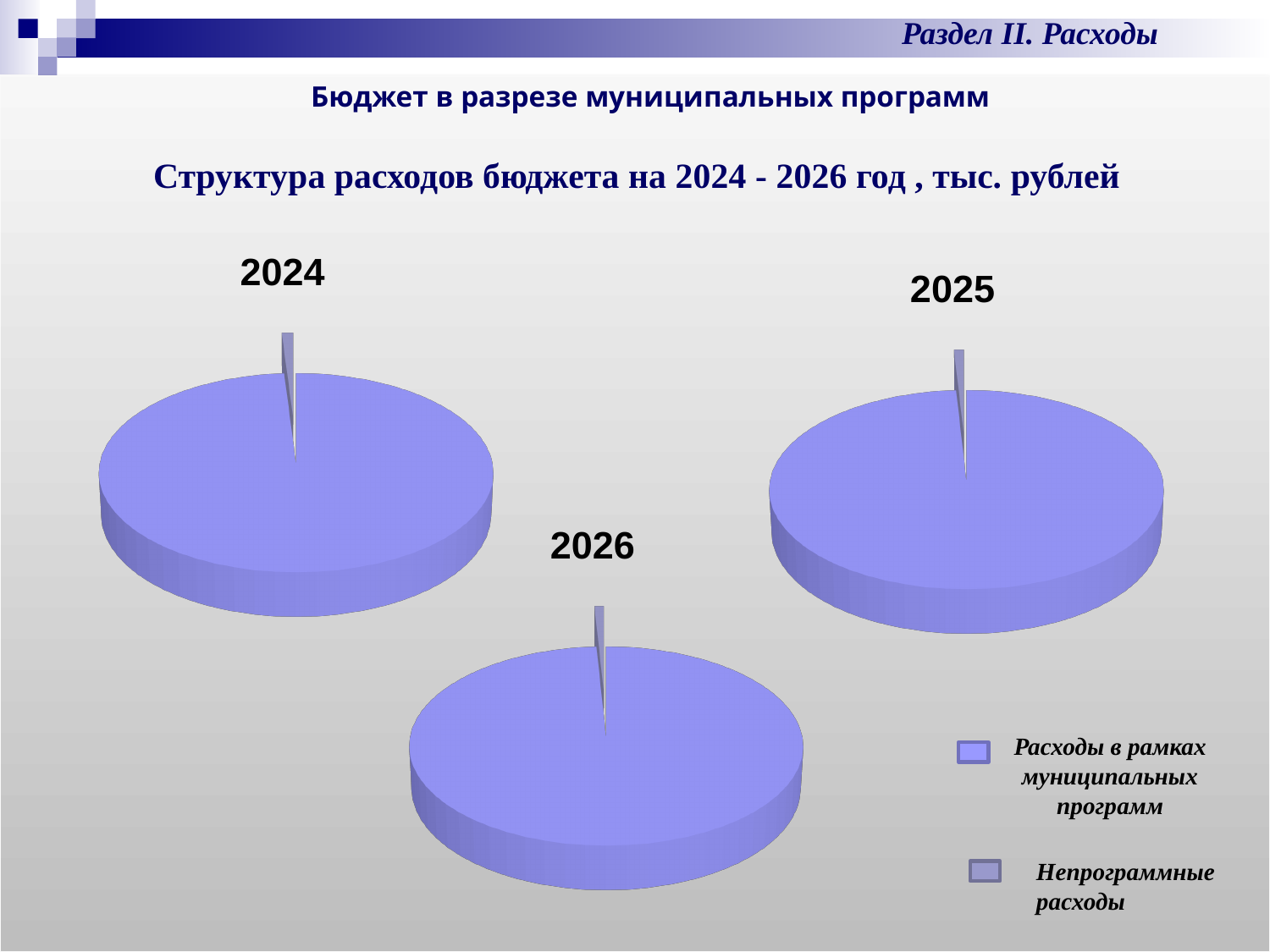
How many entries does the legend list? 2 How many slices does the 2026 pie chart have? 2 How many pie charts are shown on the slide? 3 What is the title above the three pie charts? Структура расходов бюджета на 2024 - 2026 год , тыс. рублей In the 2025 pie chart, is the slice for Непрограммные расходы larger or smaller than the slice for Расходы в рамках муниципальных программ? Smaller In the 2026 pie chart, which category takes up the largest share? Расходы в рамках муниципальных программ Which years are covered by the three pie charts? 2024, 2025, 2026 What kind of chart is used for the 2024 chart? Pie chart In the 2025 pie chart, which category has the smaller slice? Непрограммные расходы In the 2024 pie chart, which category has the larger slice: Расходы в рамках муниципальных программ or Непрограммные расходы? Расходы в рамках муниципальных программ